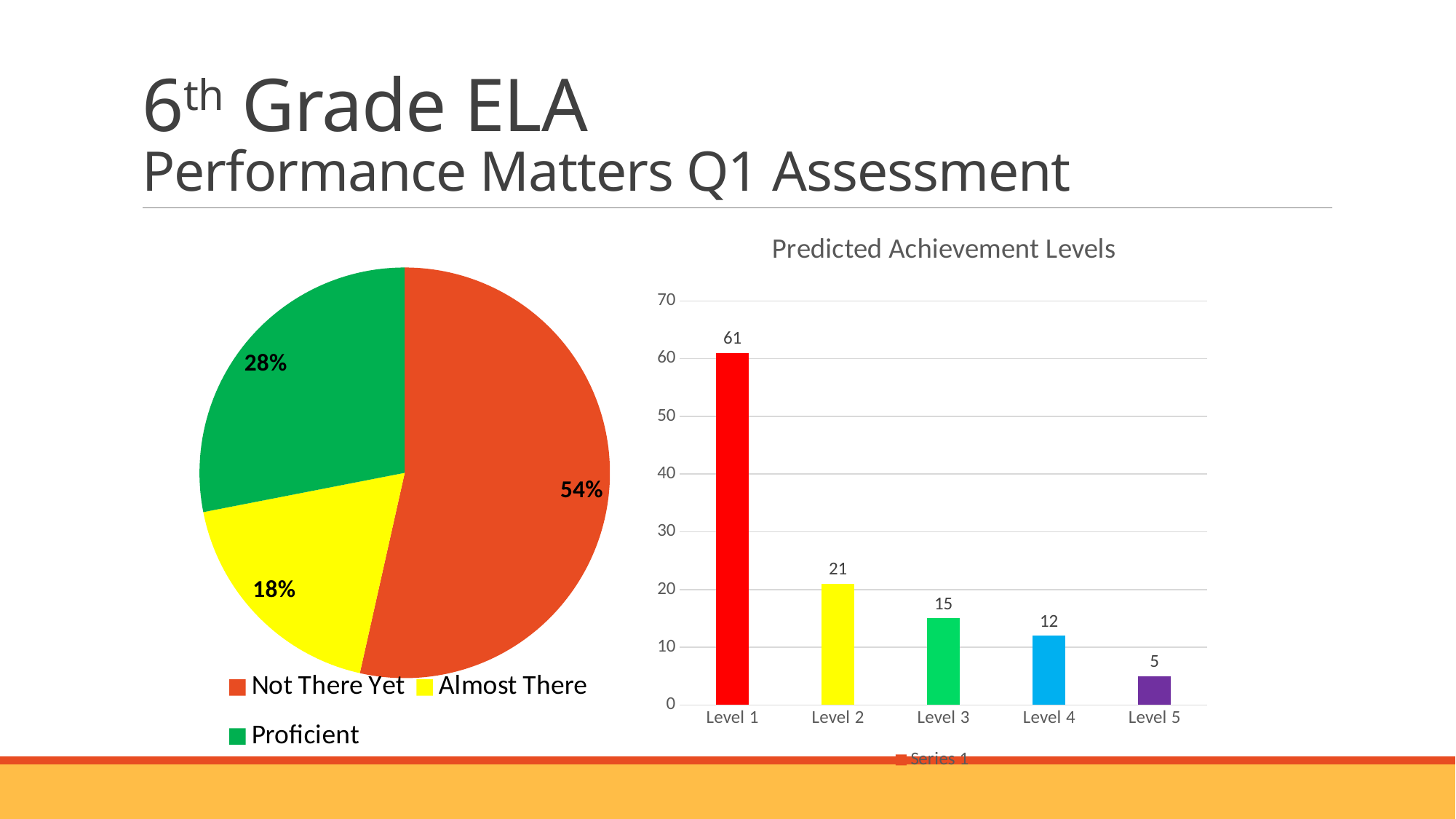
In the pie chart on the left, what percentage is shown for Not There Yet? 54% In the Predicted Achievement Levels chart, which level has the lowest value? Level 5 In the pie chart on the left, which category has the largest slice? Not There Yet In the Predicted Achievement Levels chart, what is the value for Level 1? 61 What kind of chart is the Predicted Achievement Levels chart? bar chart In the pie chart on the left, what percentage is shown for Almost There? 18% In the Predicted Achievement Levels chart, what is the difference between Level 1 and Level 2? 40 In the Predicted Achievement Levels chart, what is the value for Level 4? 12 In the pie chart on the left, how many categories does the legend list? 3 In the pie chart on the left, which category has the smallest slice? Almost There In the pie chart on the left, what percentage is shown for Proficient? 28% In the Predicted Achievement Levels chart, do the values rise or fall from Level 1 to Level 5? fall